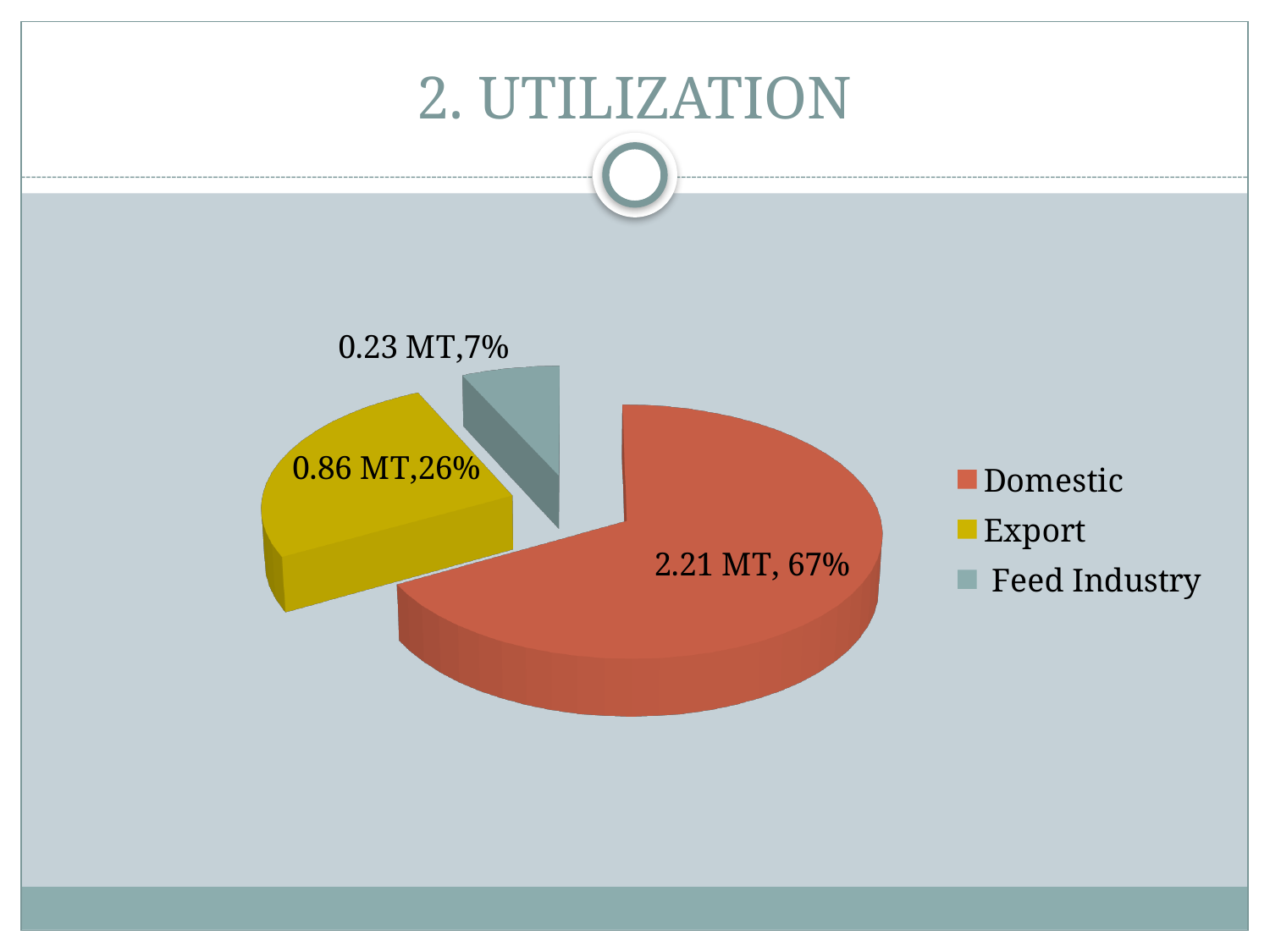
What kind of chart is shown on the slide? pie chart What is the difference in MT between Domestic and Export? 1.35 MT Which category has the smallest slice? Feed Industry What share of the pie does Export represent? 26% What is the value for Export? 0.86 MT Which is larger, Export or Feed Industry? Export What share of the pie does Domestic represent? 67% How many categories does the legend list? 3 What is the value for Feed Industry? 0.23 MT Which category has the largest slice? Domestic What is the value for Domestic? 2.21 MT What share of the pie does Feed Industry represent? 7%